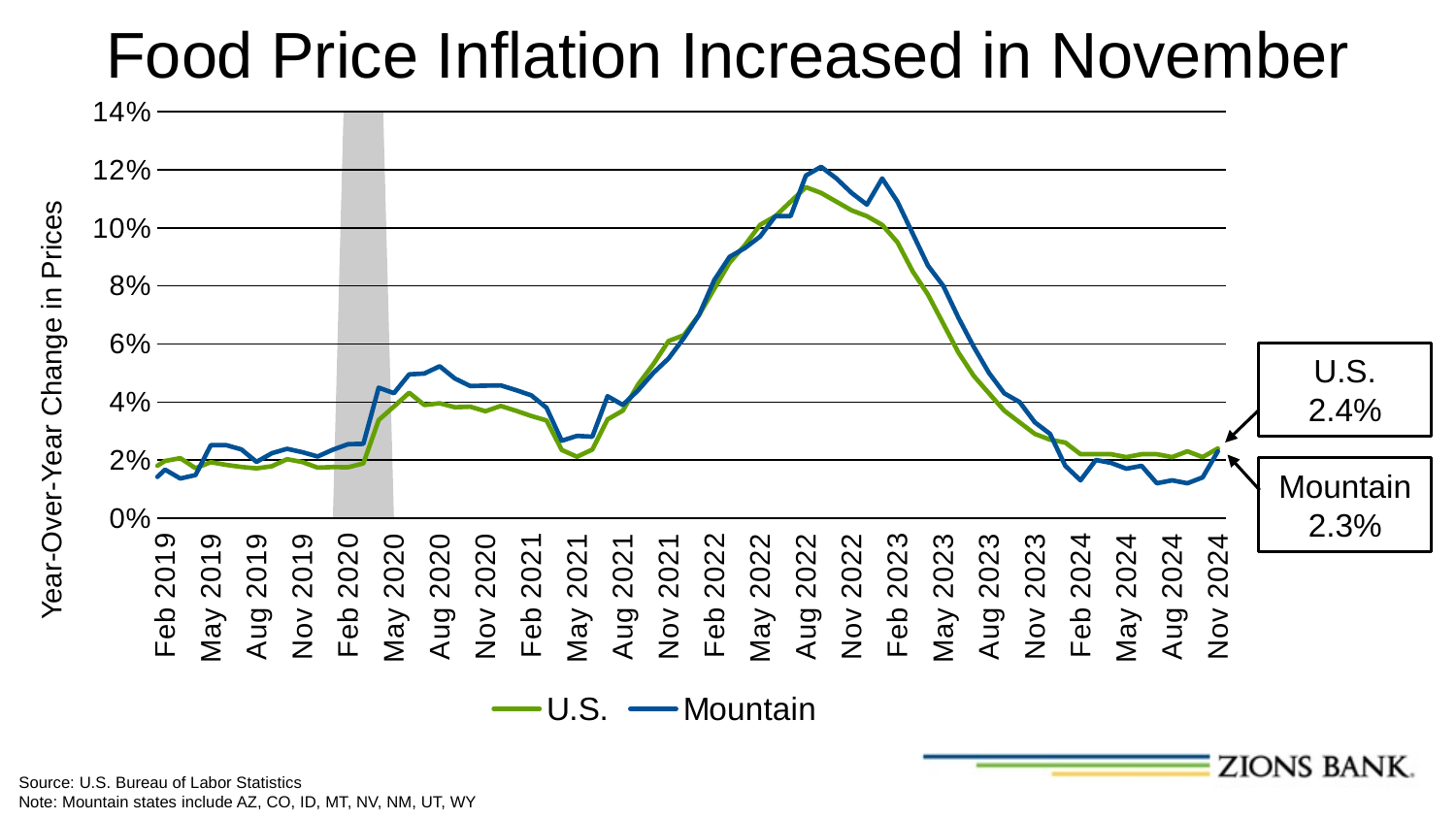
How many series does the legend list? 2 In Nov 2024, which series has the higher labeled value, U.S. or Mountain? U.S. Is the Mountain value in Feb 2024 greater or less than 2%? less What is the title of the chart? Food Price Inflation Increased in November What is the label on the vertical axis? Year-Over-Year Change in Prices What kind of chart is shown on the slide? line chart Is the Mountain value around Aug 2022 greater or less than 10%? greater Is the U.S. value in Feb 2019 greater or less than 4%? less What is the Mountain value labeled at the end of the chart (Nov 2024)? 2.3% What is the U.S. value labeled at the end of the chart (Nov 2024)? 2.4% What is the difference between the labeled U.S. and Mountain values in Nov 2024? 0.1% Do the values rise or fall between Aug 2022 and Nov 2023? fall